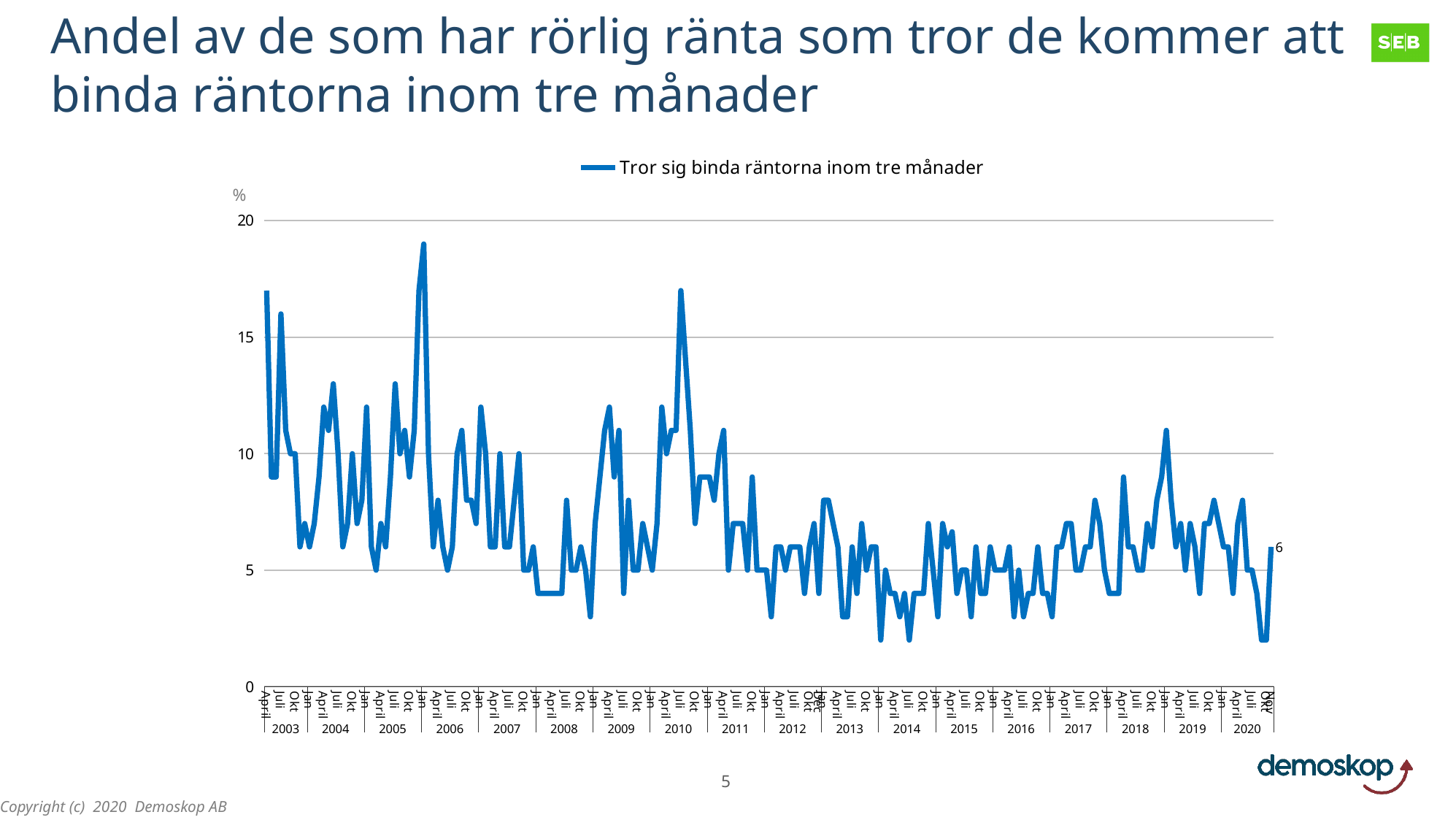
What is the value of the last data point (Nov 2020), as printed on the chart? 6 In which year does the series reach its highest peak? 2006 What kind of chart is shown on the slide? line chart Is the peak value in early 2006 greater or less than 15? greater How many series does the legend list? 1 Overall, does the series rise or fall from 2003 to 2020? fall What is the legend entry for the plotted series? Tror sig binda räntorna inom tre månader Is the lowest value in late 2020 greater or less than 5? less Which is higher: the peak in 2006 or the peak in 2010? the peak in 2006 Is the value at the start of the series in April 2003 greater or less than 15? greater What unit is shown on the y axis? % How many years are labelled on the x axis? 18